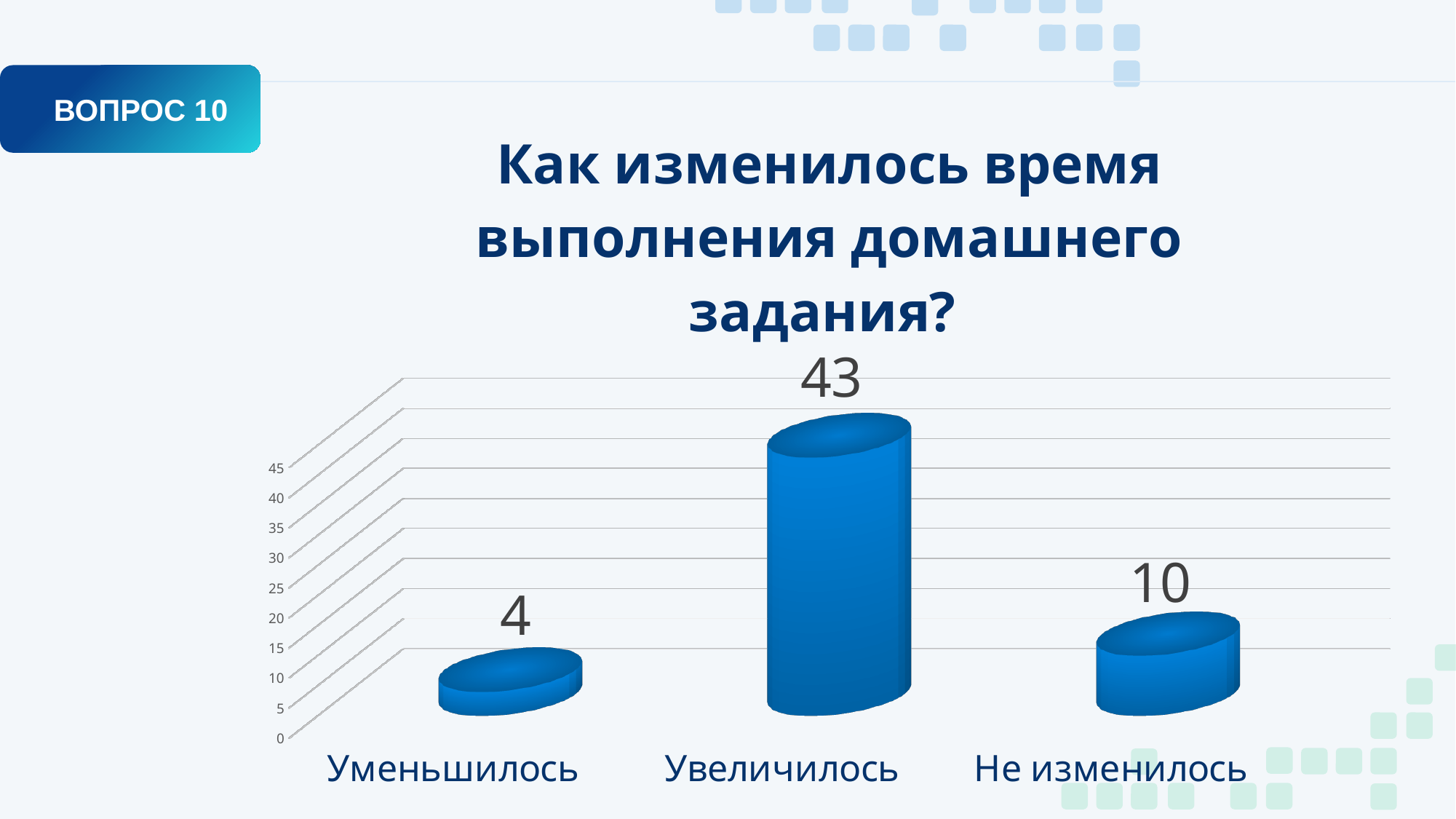
Is the value for Увеличилось greater or less than 40? greater What is the value for Не изменилось? 10 What is the difference between the values for Увеличилось and Не изменилось? 33 What is the value for Увеличилось? 43 What is the value for Уменьшилось? 4 Which category has the highest value? Увеличилось What is the title of the chart? Как изменилось время выполнения домашнего задания? How many categories are shown in the chart? 3 What is the difference between the values for Не изменилось and Уменьшилось? 6 What kind of chart is shown on the slide? bar chart Which is larger, the value for Не изменилось or the value for Уменьшилось? Не изменилось Which category has the lowest value? Уменьшилось